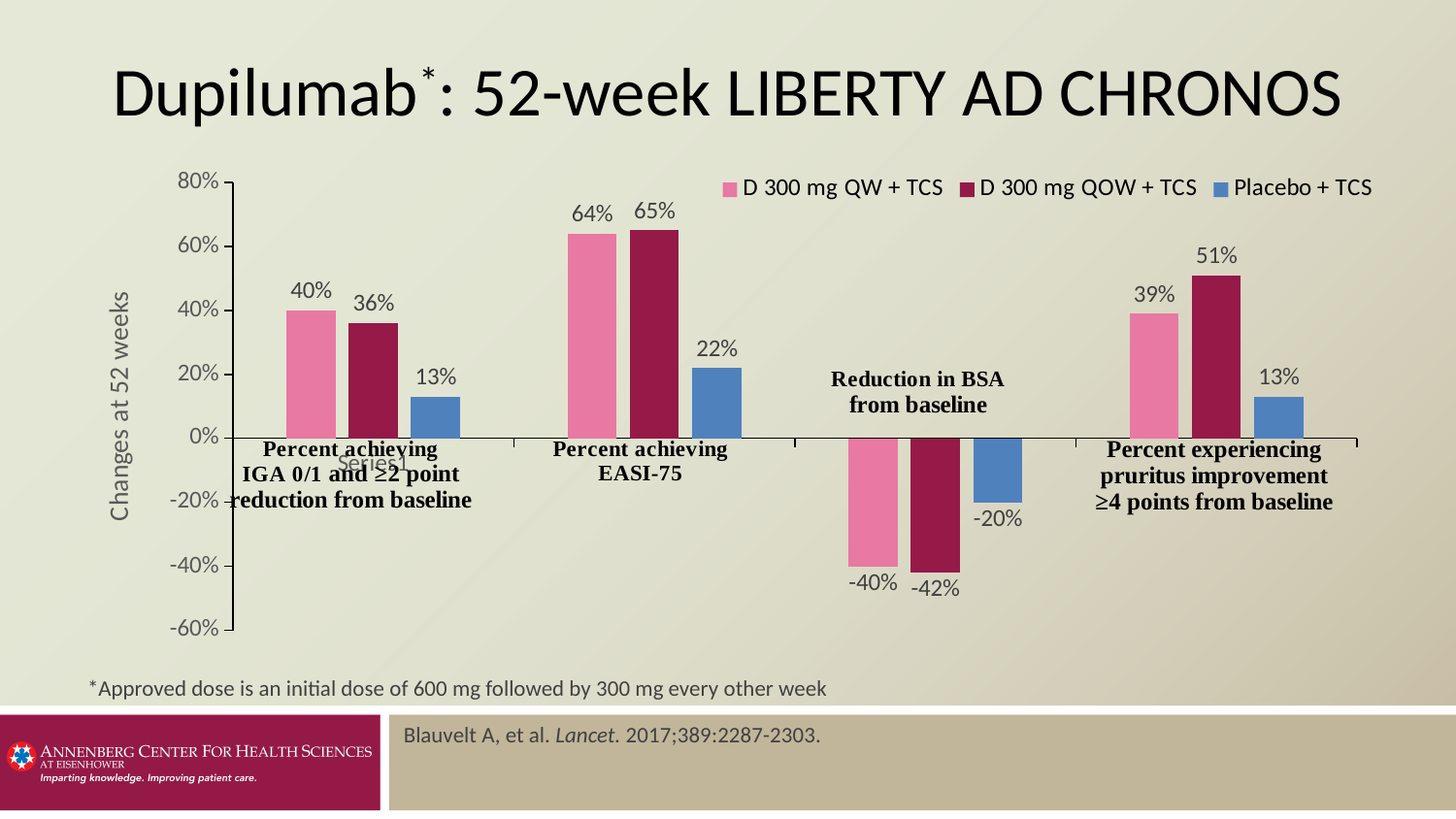
What is the difference between the D 300 mg QOW + TCS and Placebo + TCS values in the Percent experiencing pruritus improvement ≥4 points from baseline category? 38% Which series has the highest value in the Percent experiencing pruritus improvement ≥4 points from baseline category? D 300 mg QOW + TCS What is the value for Placebo + TCS in the Percent achieving EASI-75 category? 22% What is the value for D 300 mg QOW + TCS in the Percent experiencing pruritus improvement ≥4 points from baseline category? 51% What is the label of the y axis of the chart? Changes at 52 weeks What is the value for D 300 mg QW + TCS in the Reduction in BSA from baseline category? -40% What is the value for D 300 mg QW + TCS in the Percent achieving IGA 0/1 and ≥2 point reduction from baseline category? 40% In the Percent achieving IGA 0/1 and ≥2 point reduction from baseline category, which is larger: D 300 mg QW + TCS or D 300 mg QOW + TCS? D 300 mg QW + TCS Which series has the lowest value in the Percent achieving EASI-75 category? Placebo + TCS How many categories are shown on the x axis of the chart? 4 How many series does the legend list? 3 What kind of chart is shown on the slide? bar chart